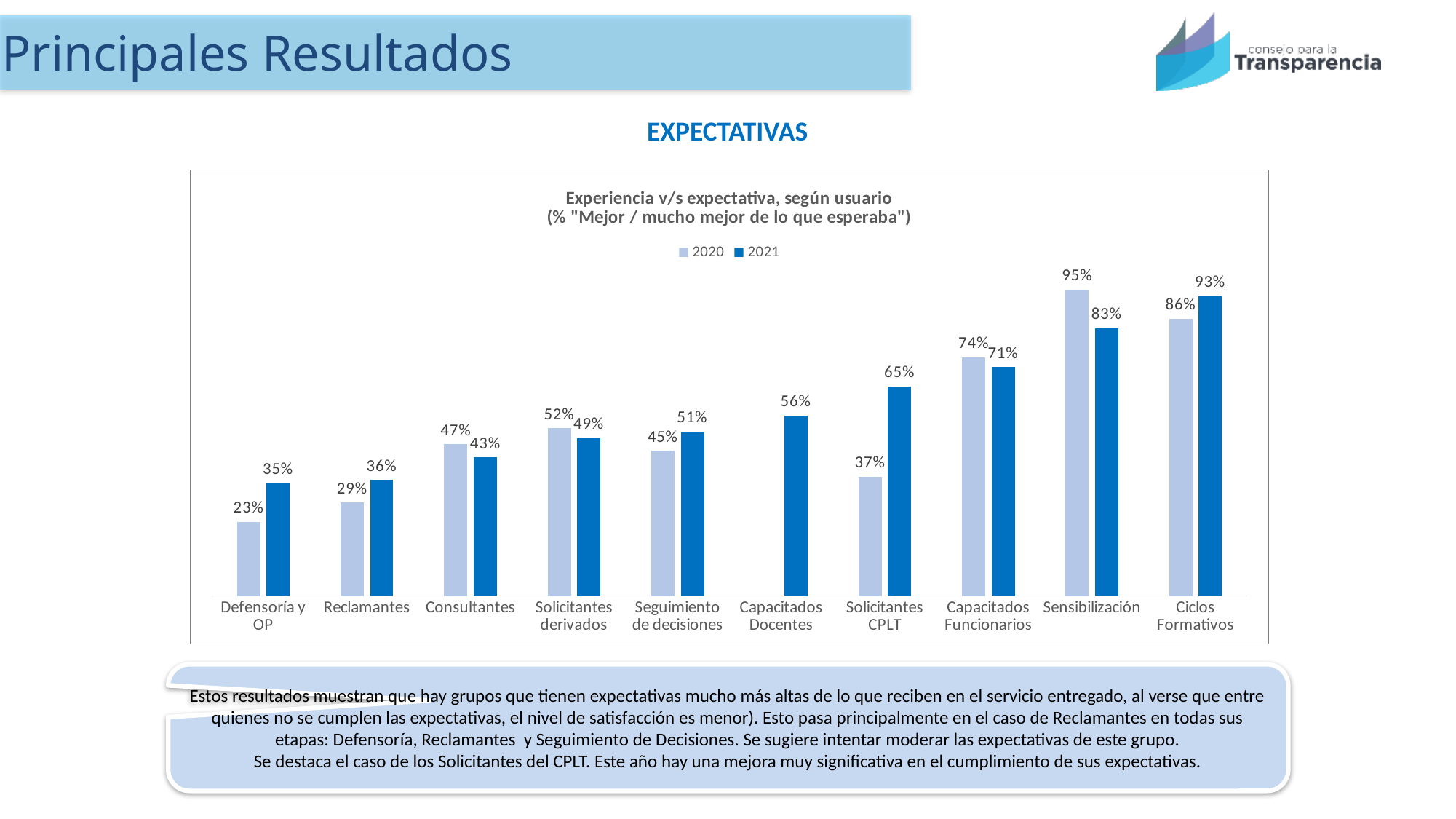
What is the difference between the 2020 values for Sensibilización and Defensoría y OP? 72% How many user categories are shown on the x axis? 10 What kind of chart is shown on the slide? Bar chart How many series does the legend list? 2 Which category has the lowest 2020 value? Defensoría y OP What is the 2020 value for Sensibilización? 95% Which category has the highest 2021 value? Ciclos Formativos What is the difference between the 2021 and 2020 values for Solicitantes CPLT? 28% For Sensibilización, which is larger, the 2020 value or the 2021 value? 2020 What is the 2021 value for Capacitados Docentes? 56% Which category has no 2020 bar shown? Capacitados Docentes What is the 2021 value for Solicitantes CPLT? 65%